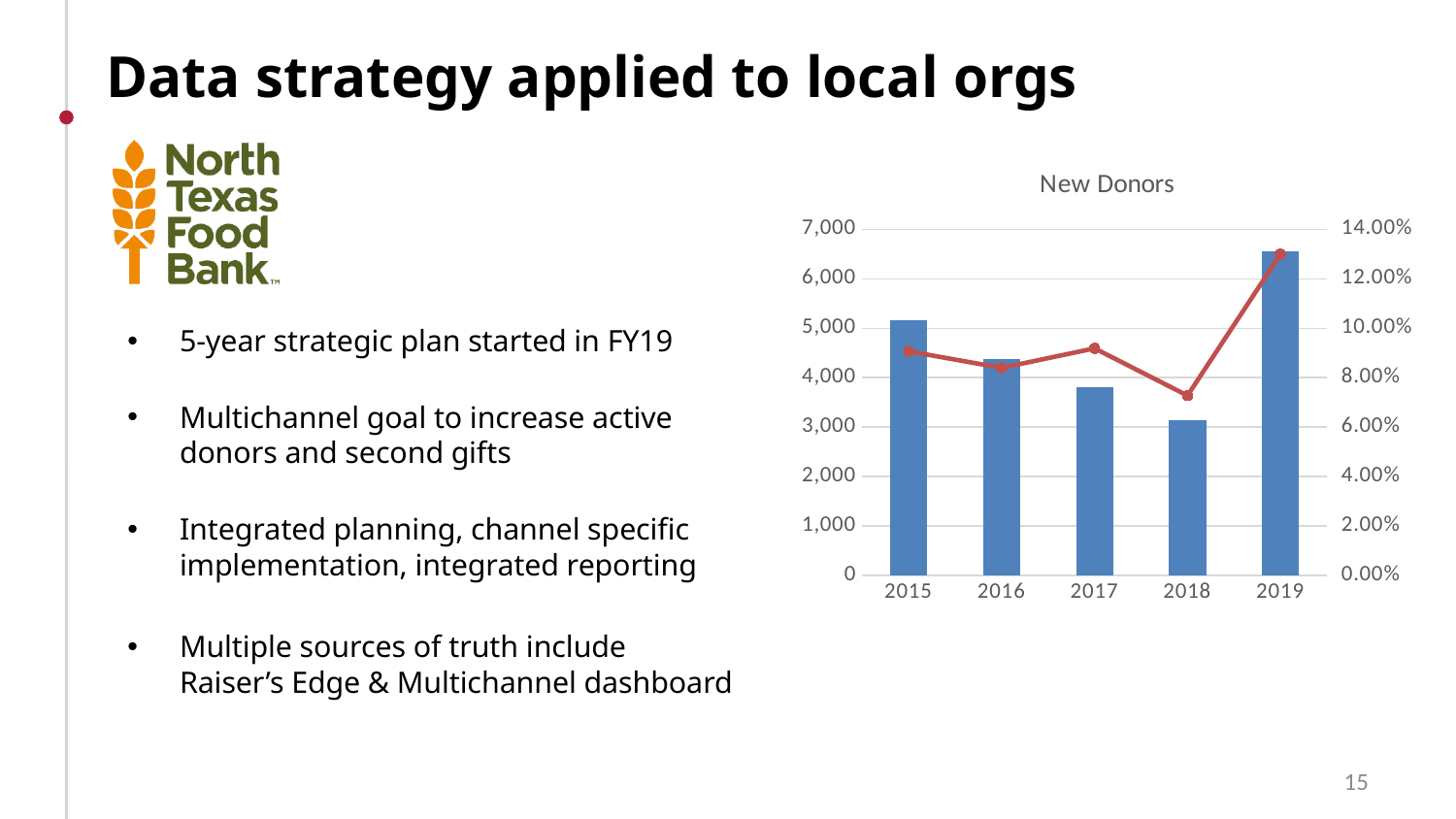
In which year does the line reach its lowest point? 2018 Do the bar values rise or fall from 2015 to 2018? fall Which year has the tallest bar in the New Donors chart? 2019 Is the bar value for 2019 greater or less than 6,000? greater Which year has the shortest bar in the New Donors chart? 2018 What is the title of the chart on the slide? New Donors Is the line value for 2019 greater or less than 12.00%? greater How many years are shown on the x axis of the New Donors chart? 5 Is the line value for 2018 greater or less than 8.00%? less Which year has a taller bar, 2015 or 2016? 2015 What kind of chart is shown on the slide? Bar chart with a line